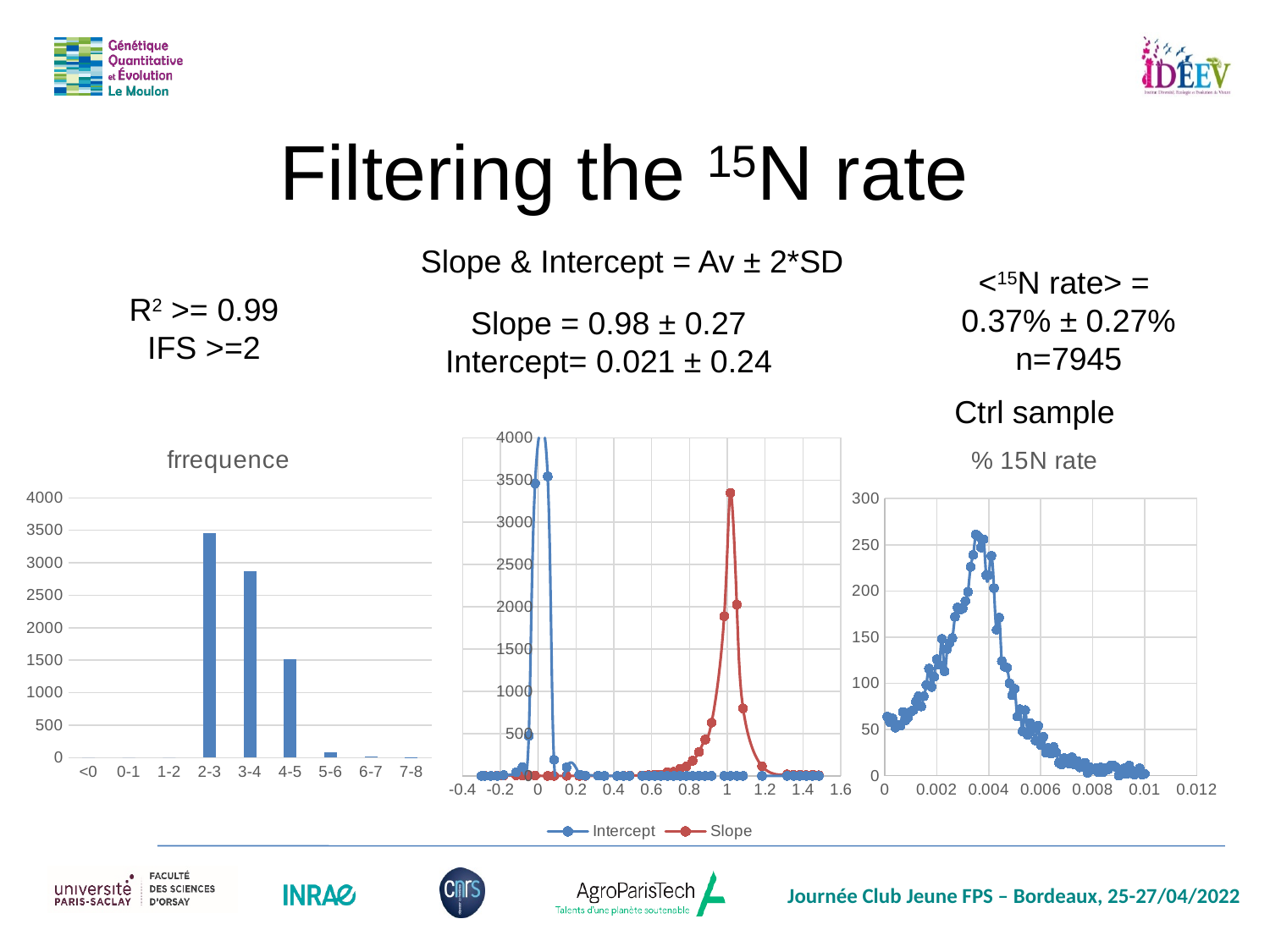
In the 'frrequence' bar chart, is the value for 3-4 greater or less than 3000? less What is the title of the chart on the right of the slide? % 15N rate In the 'frrequence' bar chart, which is larger, the value for 2-3 or the value for 3-4? 2-3 In the 'frrequence' bar chart, is the value for 2-3 greater or less than 3000? greater How many categories are shown on the x axis of the 'frrequence' bar chart? 9 In the 'frrequence' bar chart, is the value for 4-5 greater or less than 1000? greater What kind of chart is the 'frrequence' chart on the left of the slide? bar chart How many series does the legend of the middle line chart list? 2 What are the two series named in the legend of the middle line chart? Intercept and Slope In the middle line chart, which series reaches the higher peak, Intercept or Slope? Intercept In the 'frrequence' bar chart, which category has the highest bar? 2-3